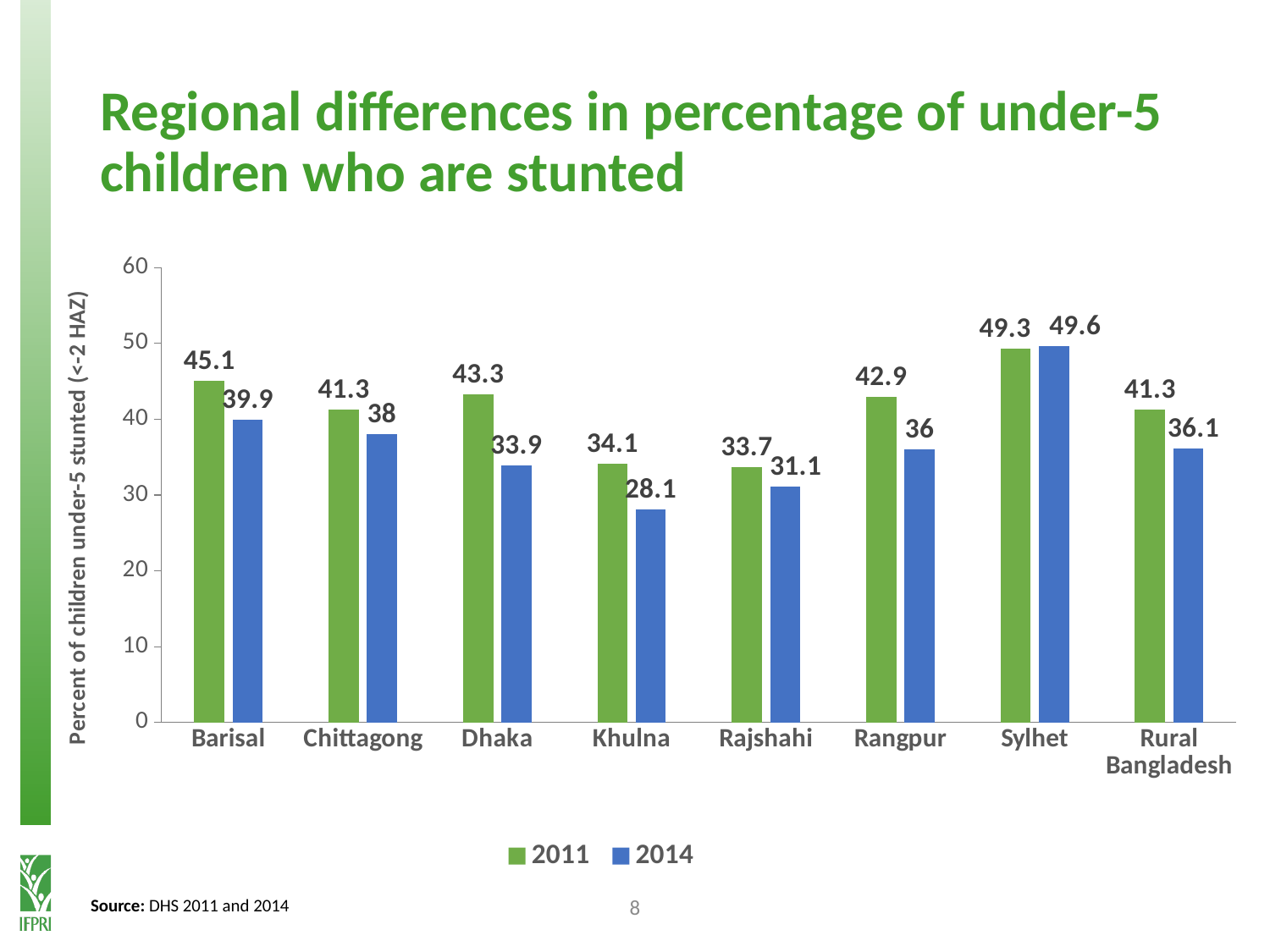
Which colour represents the 2014 series in the chart? Blue What was the percentage of stunted under-5 children in Barisal in 2011? 45.1 What was the 2014 value for Rural Bangladesh? 36.1 Which region had the highest percentage of stunted children in 2014? Sylhet What was the percentage of stunted under-5 children in Khulna in 2014? 28.1 Which region had the lowest percentage of stunted children in 2011? Rajshahi How many series does the legend list? 2 What kind of chart is shown on the slide? Bar chart Which was larger for Rangpur: the 2011 value or the 2014 value? 2011 How many regions or categories are shown on the x axis? 8 Is the 2014 value for Chittagong greater or less than 40? less By how much did the percentage of stunted children in Dhaka fall from 2011 to 2014? 9.4